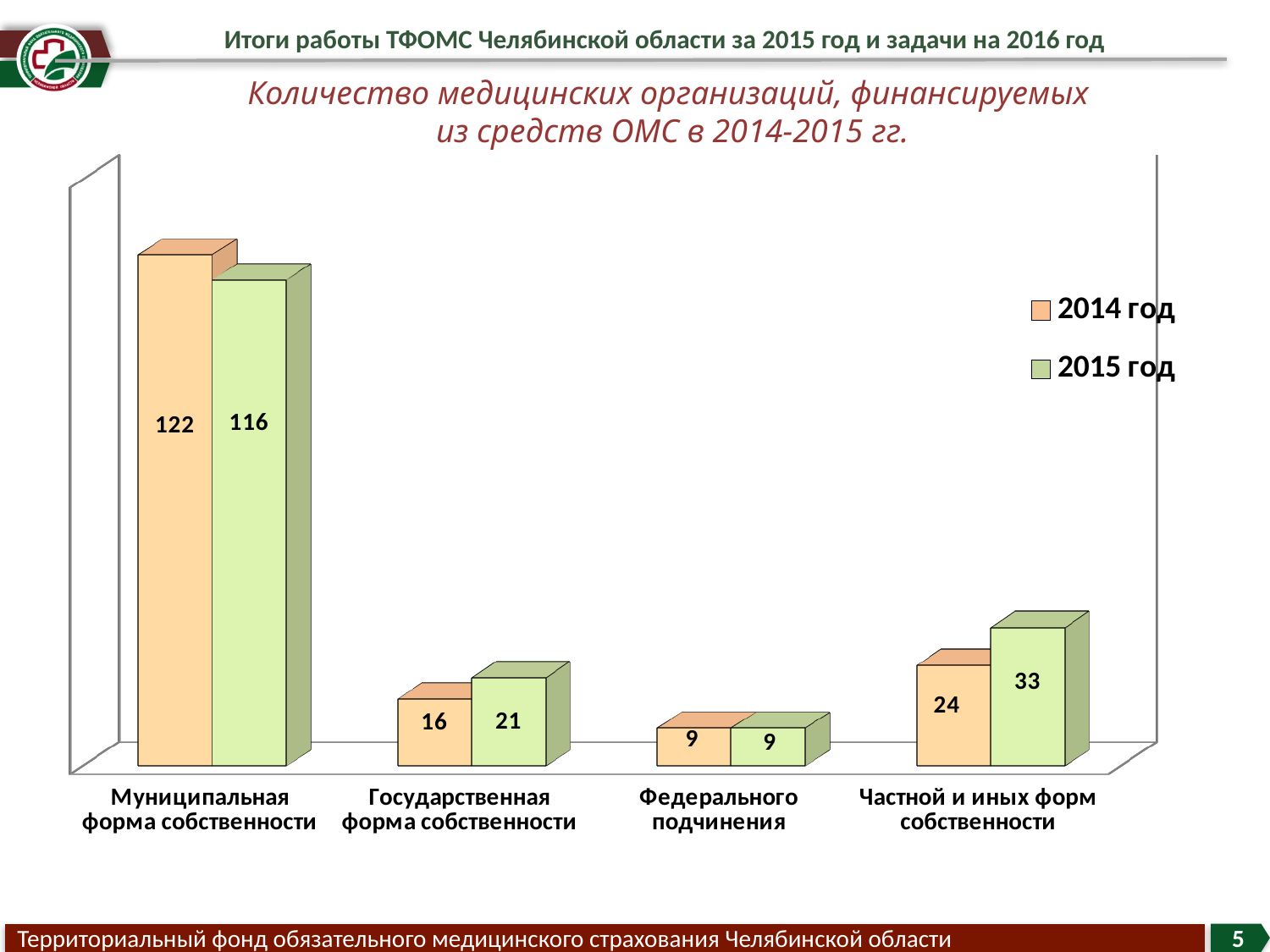
Which category has the lowest value in 2014 год? Федерального подчинения What is the value for Муниципальная форма собственности in 2014 год? 122 What is the difference between the 2015 год and 2014 год values for Частной и иных форм собственности? 9 How many series does the legend list? 2 Which series is shown in green in the legend? 2015 год Which is larger for Государственная форма собственности: the 2014 год value or the 2015 год value? 2015 год How many categories are shown on the x axis? 4 What kind of chart is shown on the slide? bar chart Which category has the highest value in 2015 год? Муниципальная форма собственности What is the difference between the 2014 год and 2015 год values for Муниципальная форма собственности? 6 What is the value for Частной и иных форм собственности in 2015 год? 33 What is the value for Государственная форма собственности in 2015 год? 21